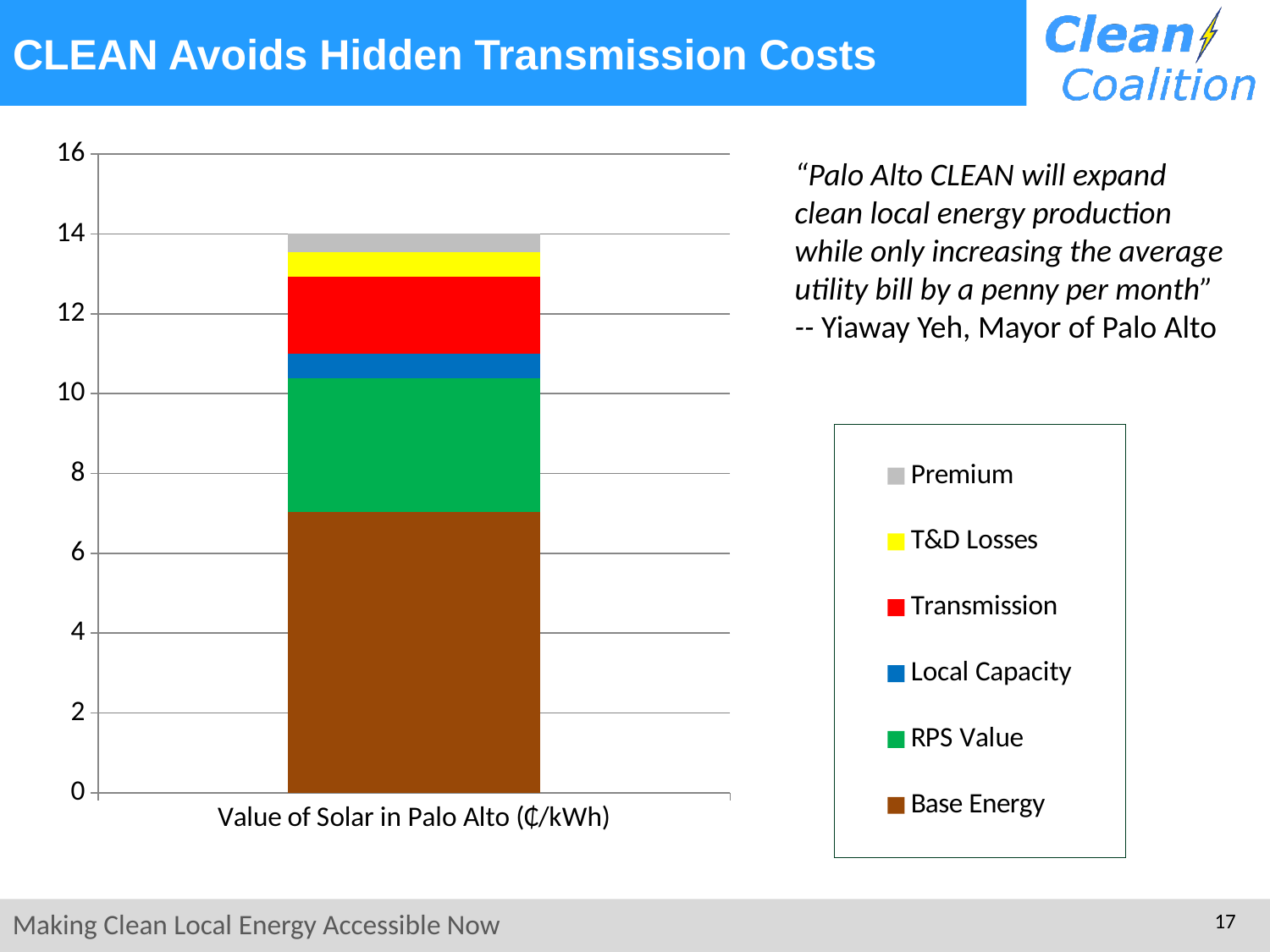
Is the Base Energy segment greater or less than 8? less Which series makes up the largest segment of the stacked bar? Base Energy Is the total height of the stacked bar greater or less than 12? greater Which segment is larger, Transmission or Local Capacity? Transmission How many categories are plotted on the x axis? 1 Which segment is larger, RPS Value or Transmission? RPS Value How many series does the legend list? 6 Is the Base Energy segment greater or less than 6? greater What kind of chart is shown on the slide? stacked bar chart Which series is shown in brown at the bottom of the stacked bar? Base Energy What is the label of the single category on the x axis? Value of Solar in Palo Alto (¢/kWh)